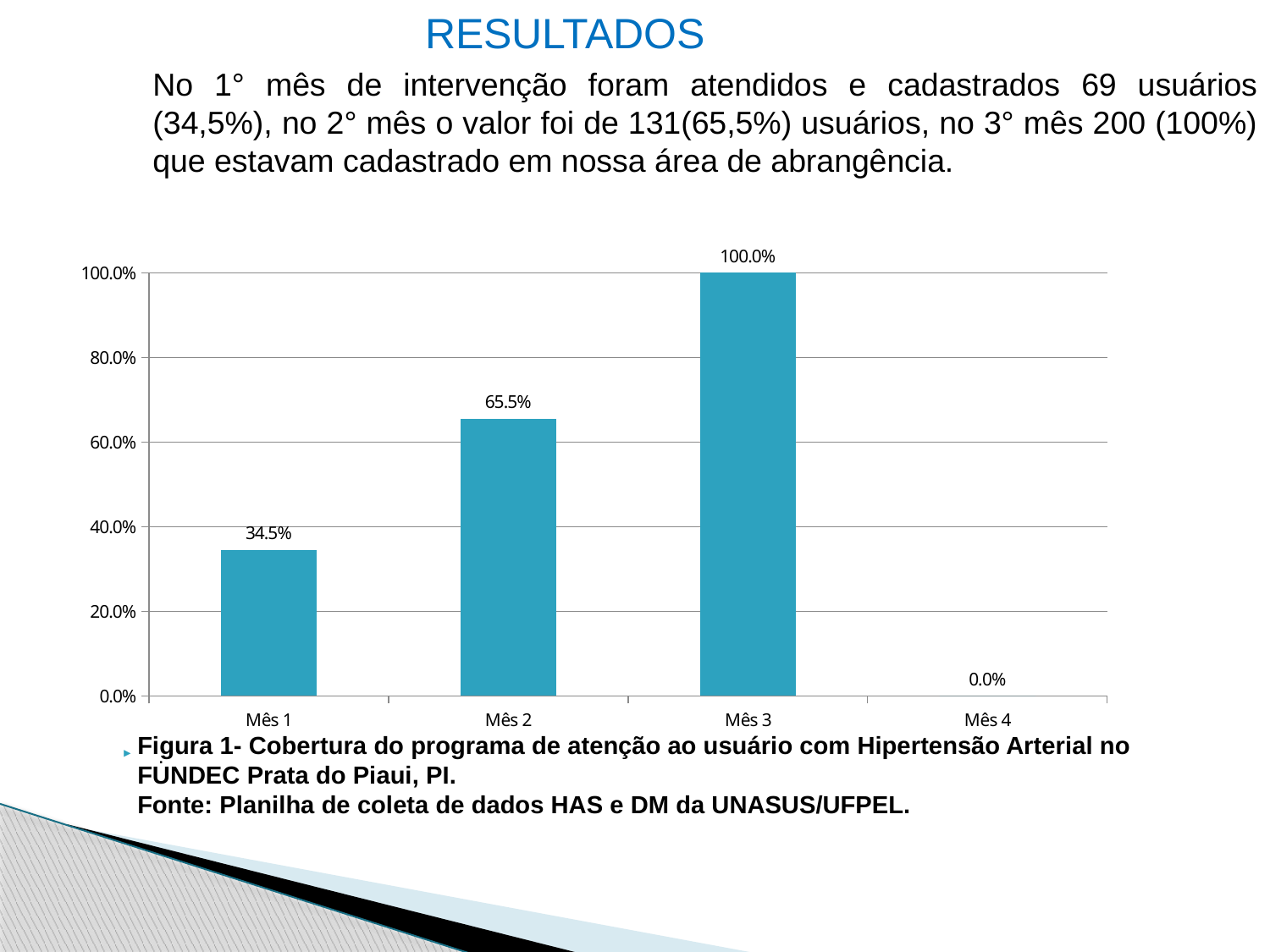
What is the value for Mês 2? 65.5% Do the values rise or fall from Mês 1 to Mês 3? rise What is the value for Mês 4? 0.0% Which category has the lowest value? Mês 4 Which is larger, the value for Mês 2 or the value for Mês 3? Mês 3 What is the difference between the values for Mês 2 and Mês 1? 31.0% Is the value for Mês 1 greater or less than 40.0%? less Which category has the highest value? Mês 3 What is the value for Mês 3? 100.0% What is the value for Mês 1? 34.5% What kind of chart is shown on the slide? bar chart How many categories are shown on the x axis? 4